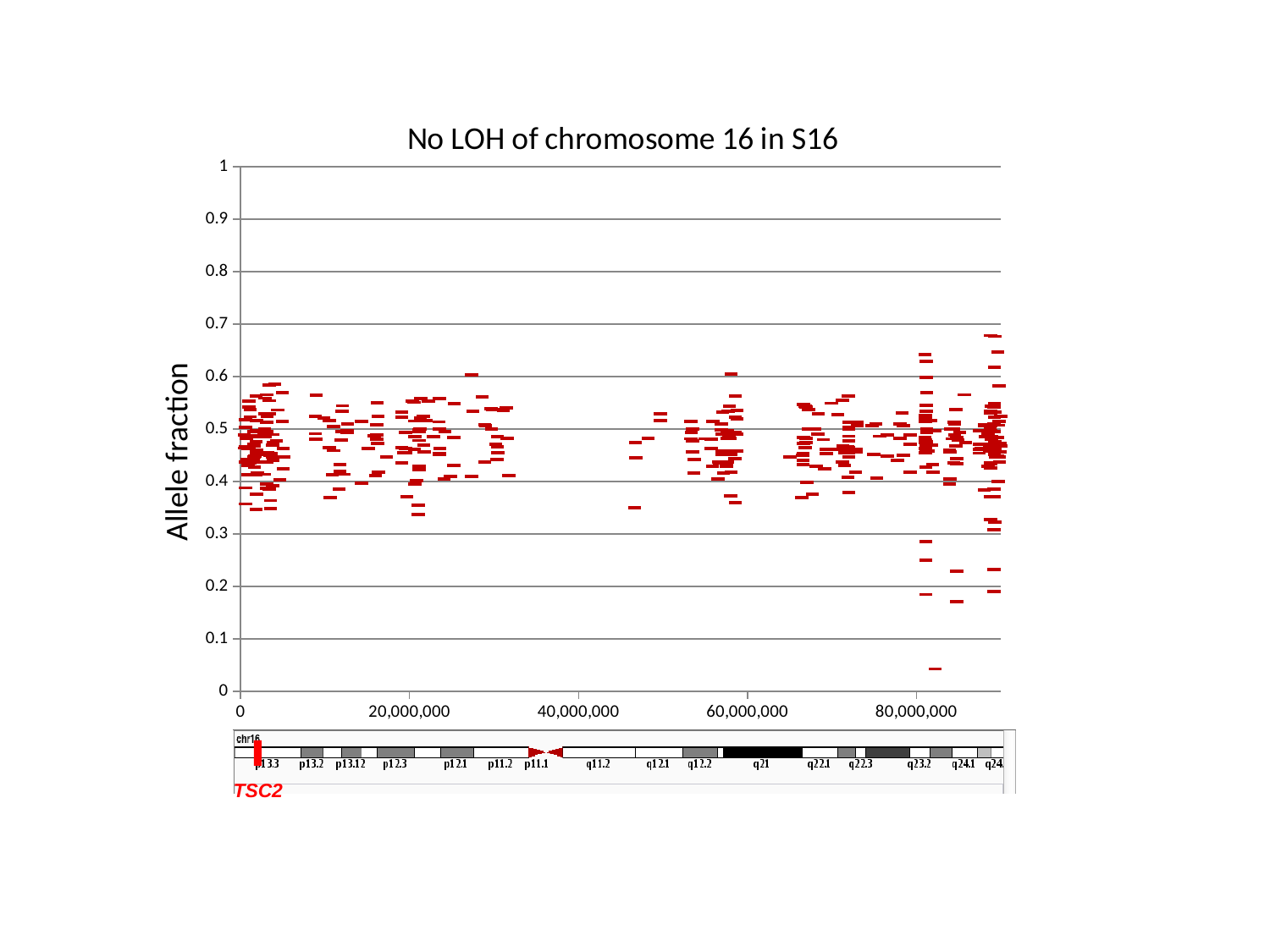
What kind of chart is shown on the slide? scatter plot Is the highest plotted allele fraction greater or less than 0.9? less What is the label on the y axis of the chart? Allele fraction What is the title of the chart? No LOH of chromosome 16 in S16 Is the lowest plotted allele fraction greater or less than 0.1? less Do the plotted allele fractions rise, fall, or stay roughly flat along the x axis? roughly flat Is the lowest plotted allele fraction greater or less than 0.2? less